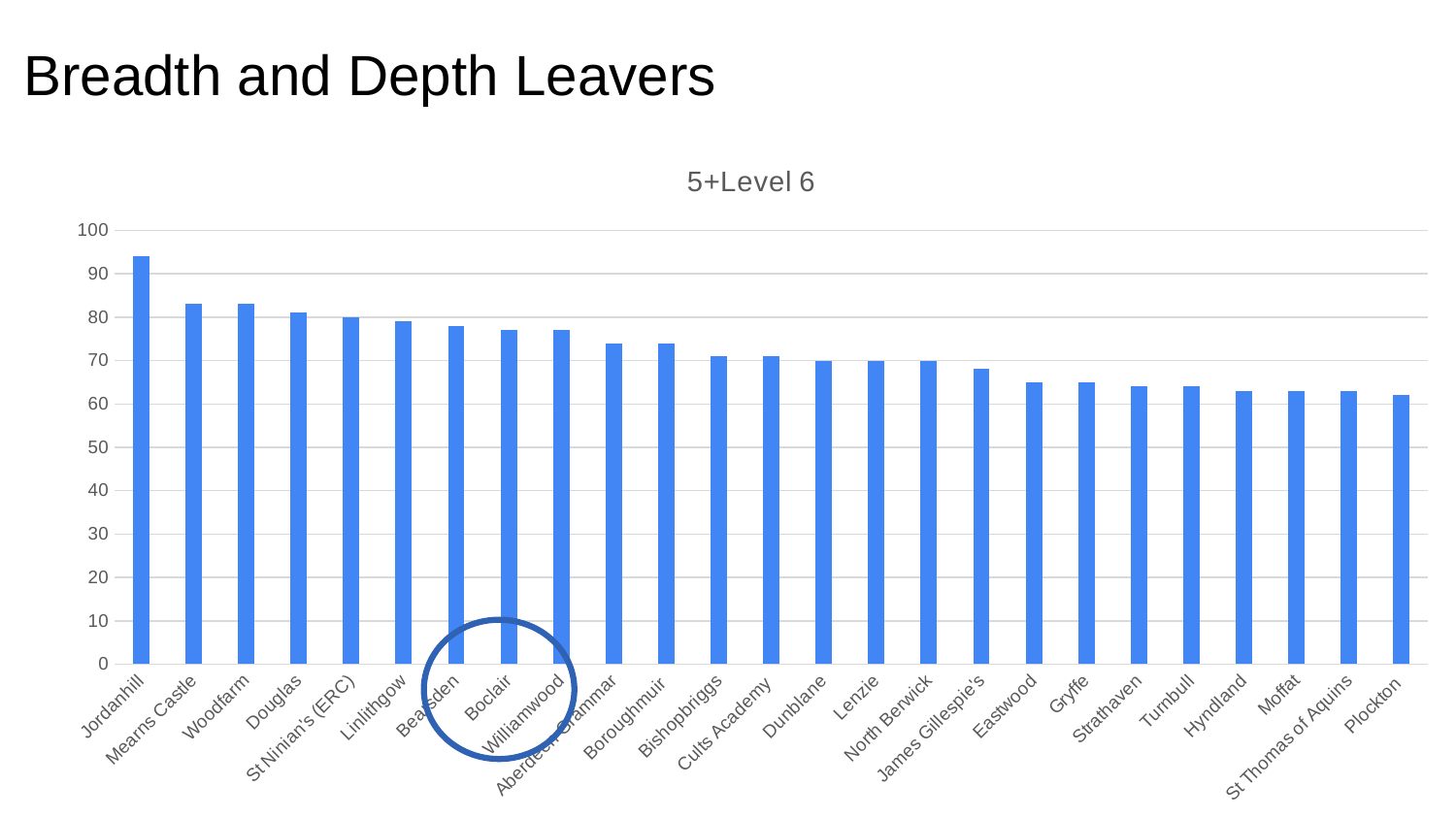
What kind of chart is shown on the slide? bar chart Is the value for Jordanhill greater or less than 90? greater What is the title of the chart? 5+Level 6 Is the value for Mearns Castle greater or less than 80? greater Do the values rise or fall moving from left to right along the x axis? fall Which has the larger value, Douglas or Eastwood? Douglas How many schools are shown on the x axis of the chart? 25 Which school's label is circled on the x axis of the chart? Boclair Is the value for Plockton greater or less than 60? greater Which school has the highest value in the chart? Jordanhill